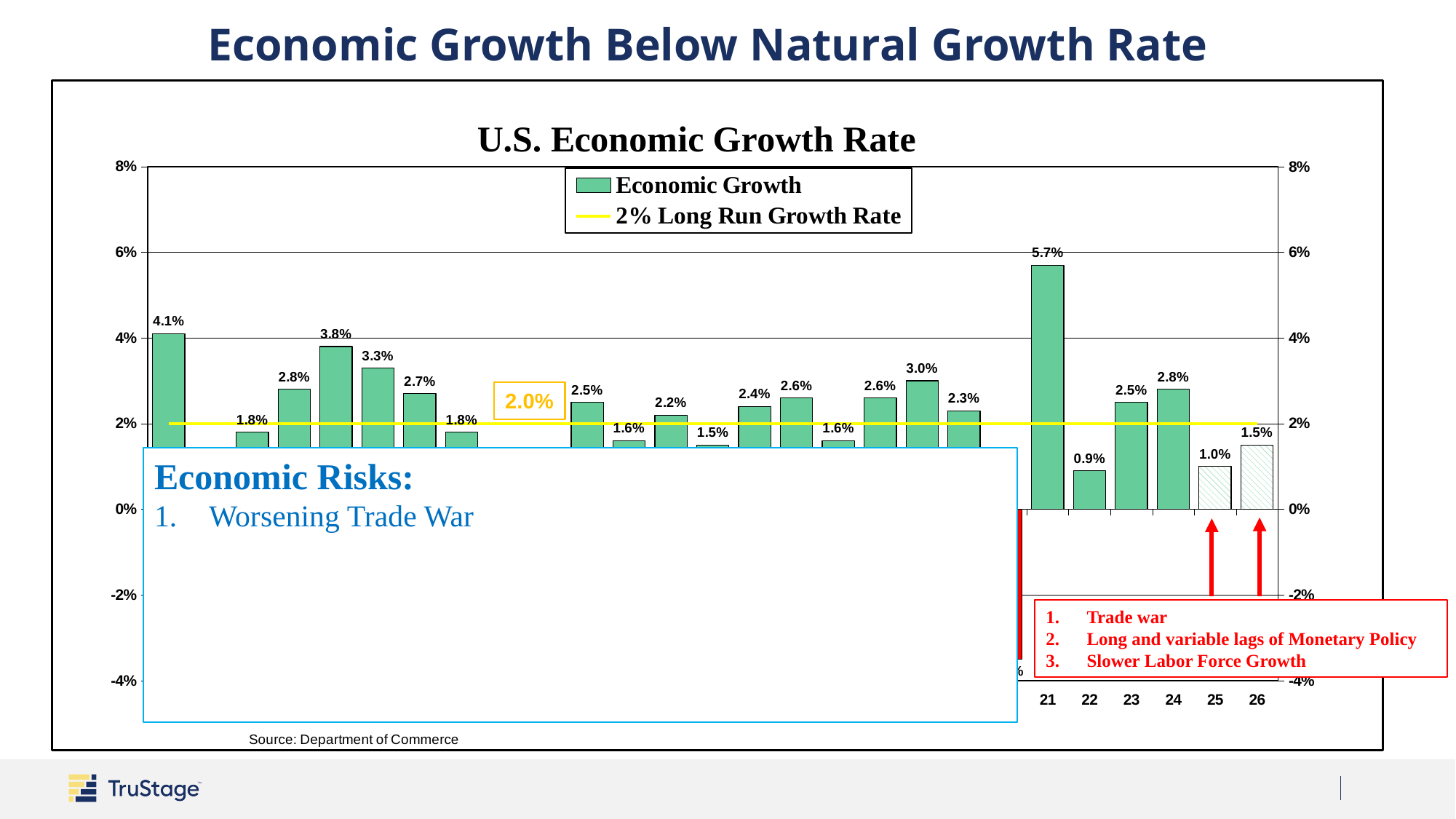
Which year has the highest economic growth rate on the chart? 21 What kind of chart is used to show the economic growth data? bar chart How many series does the legend list? 2 What is the economic growth rate shown for 24? 2.8% Is the value for 25 greater or less than 2%? less Among the years 21 through 26, which has the lowest economic growth rate? 22 What is the economic growth rate shown for 21? 5.7% Which year has the larger growth rate, 23 or 24? 24 What is the economic growth rate shown for 22? 0.9% What is the title of the chart? U.S. Economic Growth Rate What is the difference between the growth rates for 21 and 22? 4.8 percentage points What is the economic growth rate shown for 26? 1.5%